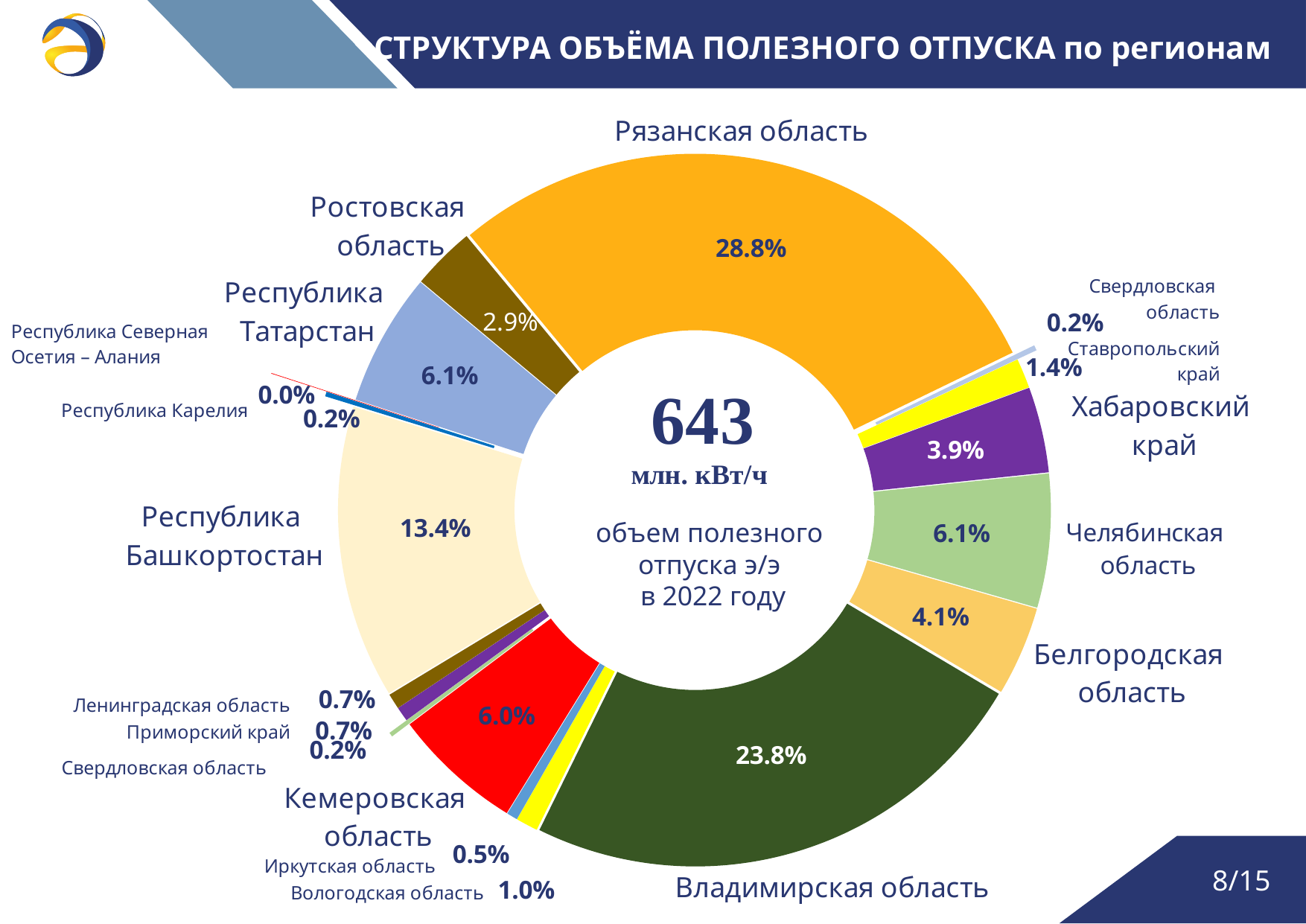
By how many percentage points does Рязанская область exceed Владимирская область? 5.0 Which has a larger share: Белгородская область or Ростовская область? Белгородская область What share of the chart does Рязанская область account for? 28.8% What is the value shown for Кемеровская область? 6.0% What total value is printed in the centre of the chart? 643 млн. кВт/ч Which region has the smallest share in the chart? Республика Северная Осетия – Алания What percentage is shown for Владимирская область? 23.8% What percentage is labelled for Хабаровский край? 3.9% Which region has the largest share in the chart? Рязанская область Which has a larger share: Ставропольский край or Вологодская область? Ставропольский край What kind of chart is shown on the slide? Pie (donut) chart What is the value for Республика Башкортостан? 13.4%